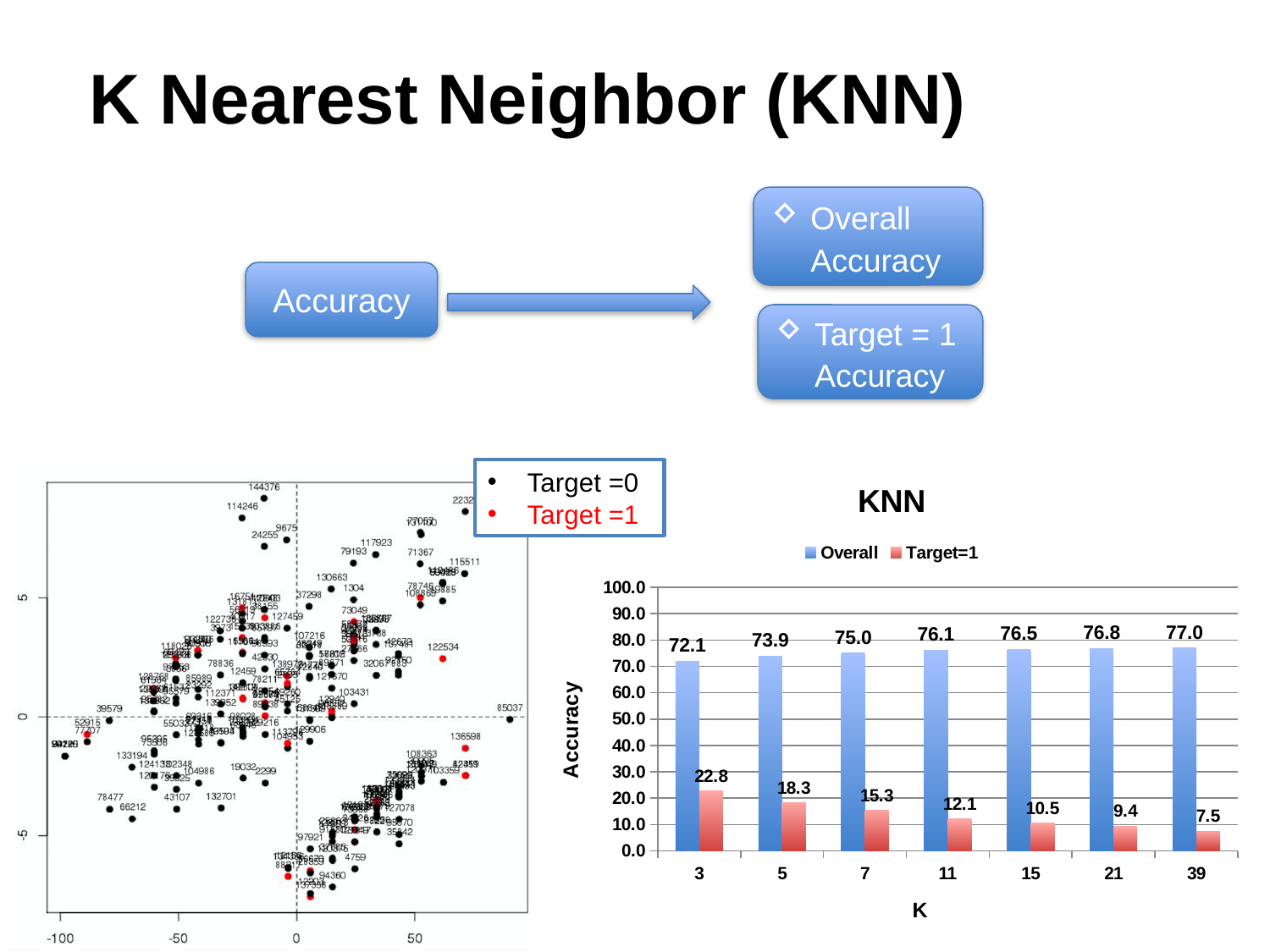
In the KNN chart, which value of K has the lowest Target=1 accuracy? 39 In the KNN chart, how many series does the legend list? 2 In the KNN chart, how many values of K are shown on the x axis? 7 In the KNN chart, which is larger: the Target=1 accuracy at K = 7 or at K = 15? K = 7 In the KNN chart, what is the Overall accuracy for K = 3? 72.1 In the KNN chart, what is the Target=1 accuracy for K = 11? 12.1 In the scatter plot on the left of the slide, what colour are the points for Target =1? red In the KNN chart, which value of K has the highest Overall accuracy? 39 What kind of chart is the KNN chart on the right of the slide? bar chart In the KNN chart, does the Target=1 accuracy rise or fall as K increases? fall In the KNN chart, what is the difference between the Overall accuracy and the Target=1 accuracy at K = 5? 55.6 In the KNN chart, what is the Target=1 accuracy for K = 39? 7.5